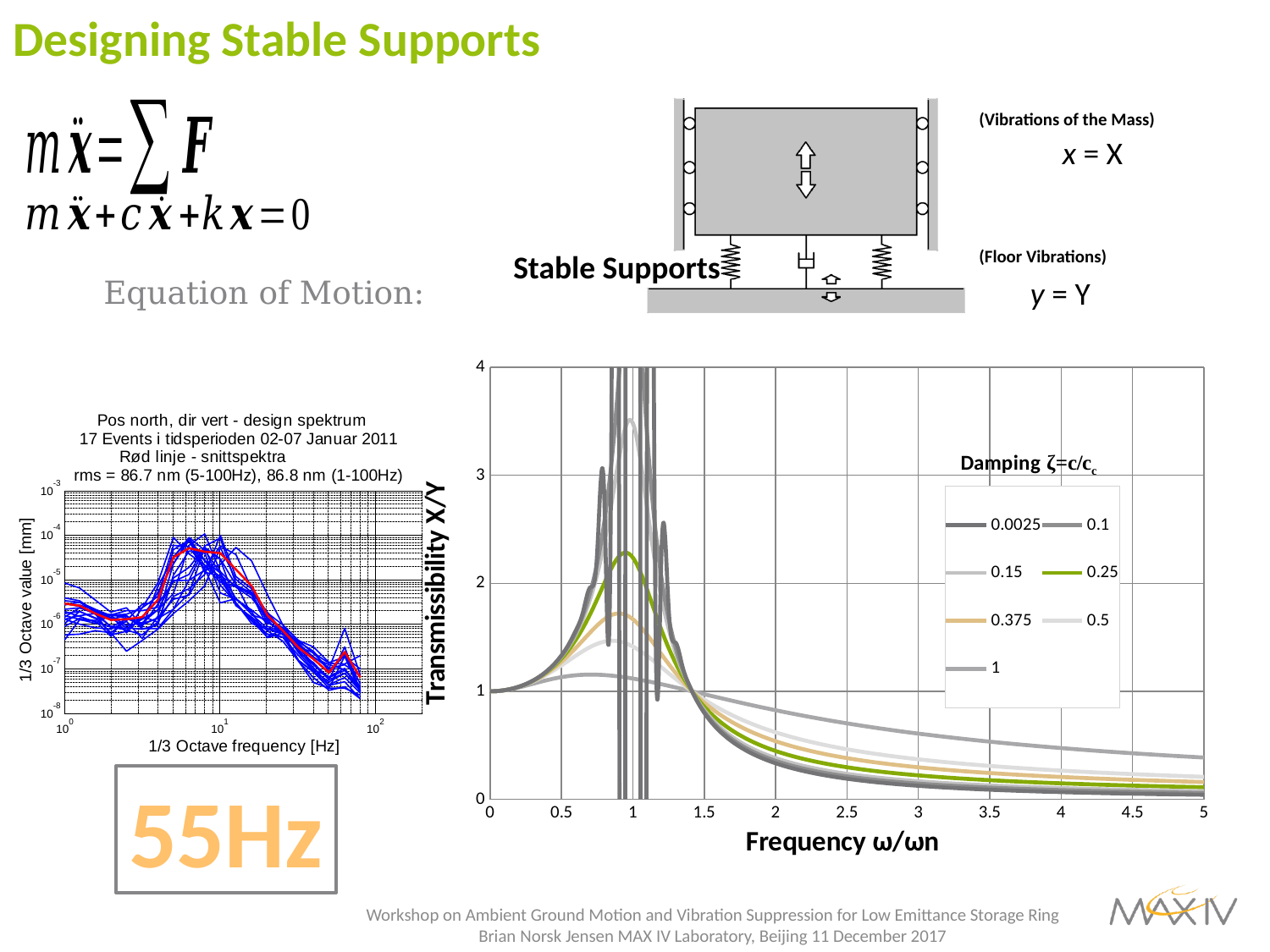
On the transmissibility chart, which colour is the damping 0.25 curve? green What is the x-axis label of the small spectrum chart on the left of the slide? 1/3 Octave frequency [Hz] On the transmissibility chart, is the peak value of the damping 0.25 curve greater or less than 2? greater On the transmissibility chart, is the peak value of the damping 1 curve greater or less than 2? less On the transmissibility chart, do the curves rise or fall as ω/ωn increases from 2 to 5? fall On the transmissibility chart, is the value of the damping 0.25 curve at ω/ωn = 5 greater or less than 1? less What is the x-axis label of the transmissibility chart? Frequency ω/ωn On the transmissibility chart, what is the transmissibility X/Y of the curves at frequency ω/ωn = 0? 1 What kind of chart is the transmissibility chart on the right of the slide? line chart How many damping values does the legend of the transmissibility chart list? 7 On the transmissibility chart, which damping curve has the lowest peak? 1